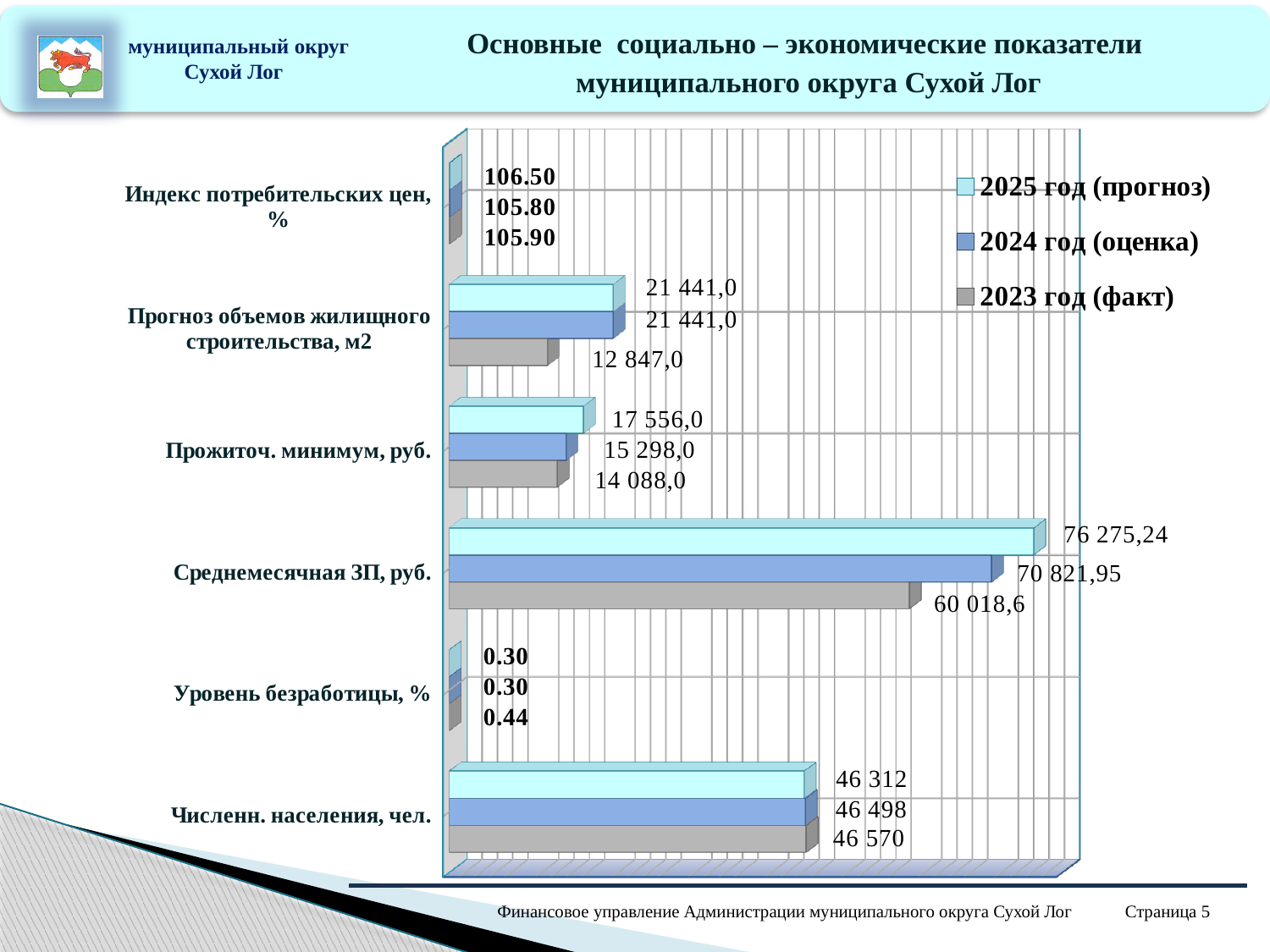
What is the value for Уровень безработицы, % in the 2023 год (факт) series? 0.44 Which year has the lowest value for Численн. населения, чел.? 2025 год (прогноз) What is the value for Индекс потребительских цен, % in the 2025 год (прогноз) series? 106.50 What is the difference between the 2024 год (оценка) and 2023 год (факт) values for Прогноз объемов жилищного строительства, м2? 8 594,0 Which year has the highest value for Среднемесячная ЗП, руб.? 2025 год (прогноз) What is the value for Прожиточ. минимум, руб. in the 2023 год (факт) series? 14 088,0 What kind of chart is shown on the slide? Bar chart What is the difference between the 2025 год (прогноз) and 2023 год (факт) values for Среднемесячная ЗП, руб.? 16 256,64 For Прожиточ. минимум, руб., which is larger: the 2025 год (прогноз) value or the 2024 год (оценка) value? 2025 год (прогноз) How many series does the legend list? 3 What is the value for Численн. населения, чел. in the 2024 год (оценка) series? 46 498 What is the value for Среднемесячная ЗП, руб. in the 2025 год (прогноз) series? 76 275,24